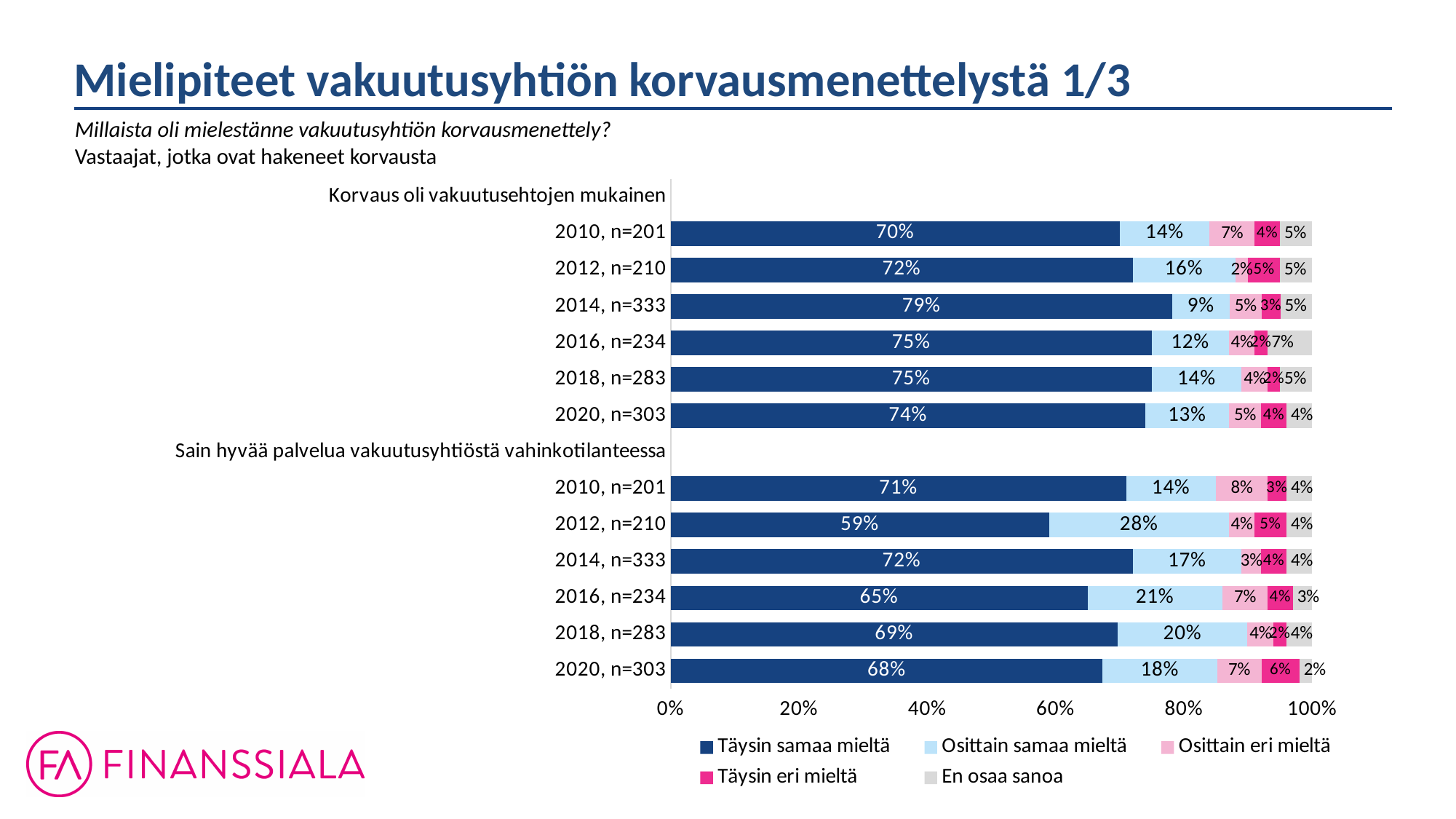
For 2016, n=234, which is larger: the 'Täysin samaa mieltä' share for 'Korvaus oli vakuutusehtojen mukainen' or for 'Sain hyvää palvelua vakuutusyhtiöstä vahinkotilanteessa'? Korvaus oli vakuutusehtojen mukainen How many percentage points higher is the 'Täysin samaa mieltä' share for 'Korvaus oli vakuutusehtojen mukainen' in 2014 than in 2010? 9 percentage points How many series does the legend list? 5 Which legend entry is shown in dark blue? Täysin samaa mieltä Which year has the highest 'Täysin samaa mieltä' share for 'Korvaus oli vakuutusehtojen mukainen'? 2014, n=333 Which year has the lowest 'Täysin samaa mieltä' share for 'Sain hyvää palvelua vakuutusyhtiöstä vahinkotilanteessa'? 2012, n=210 Is the 'Täysin samaa mieltä' share for 2012, n=210 in the 'Sain hyvää palvelua vakuutusyhtiöstä vahinkotilanteessa' group greater or less than 60%? less What is the 'Täysin eri mieltä' share for 2020, n=303 in the 'Sain hyvää palvelua vakuutusyhtiöstä vahinkotilanteessa' group? 6% What share of respondents in 2014 (n=333) were 'Täysin samaa mieltä' that 'Korvaus oli vakuutusehtojen mukainen'? 79% What kind of chart is shown on the slide? Stacked bar chart How many bars are plotted on the chart in total? 12 In the 'Sain hyvää palvelua vakuutusyhtiöstä vahinkotilanteessa' group, what is the 'Osittain samaa mieltä' share for 2012, n=210? 28%